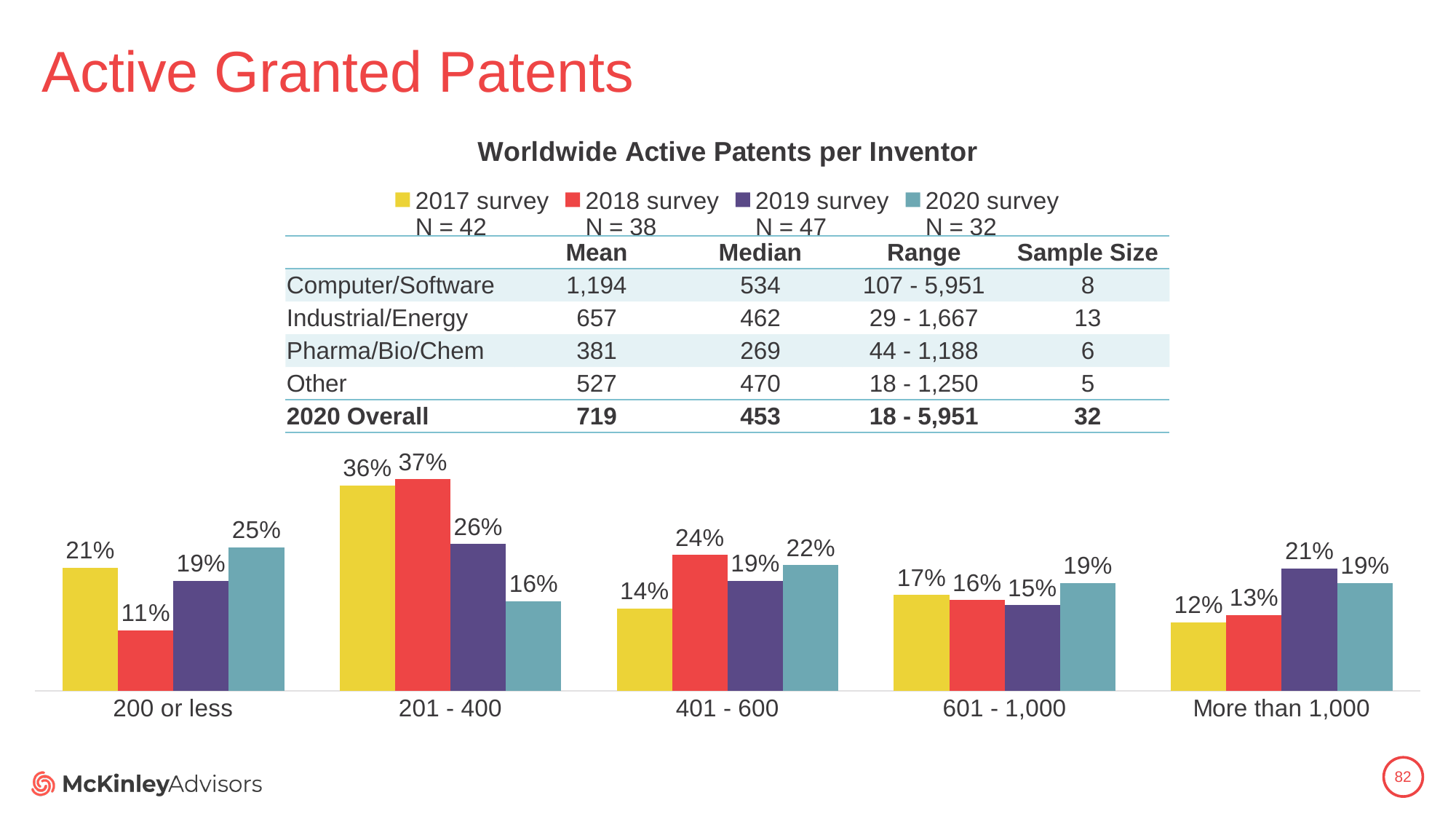
Which category has the highest value for the 2017 survey? 201 - 400 What is the value for the 2017 survey in the "401 - 600" category? 14% What kind of chart is shown on the slide? Bar chart What is the value for the 2019 survey in the "More than 1,000" category? 21% What is the value for the 2020 survey in the "200 or less" category? 25% How many categories are shown on the x axis of the chart? 5 In the "401 - 600" category, which is larger: the 2018 survey value or the 2017 survey value? 2018 survey How many series does the chart legend list? 4 What is the title of the chart? Worldwide Active Patents per Inventor What is the value for the 2018 survey in the "201 - 400" category? 37% What is the difference between the 2018 survey and the 2020 survey values in the "201 - 400" category? 21% Which category has the lowest value for the 2018 survey? 200 or less